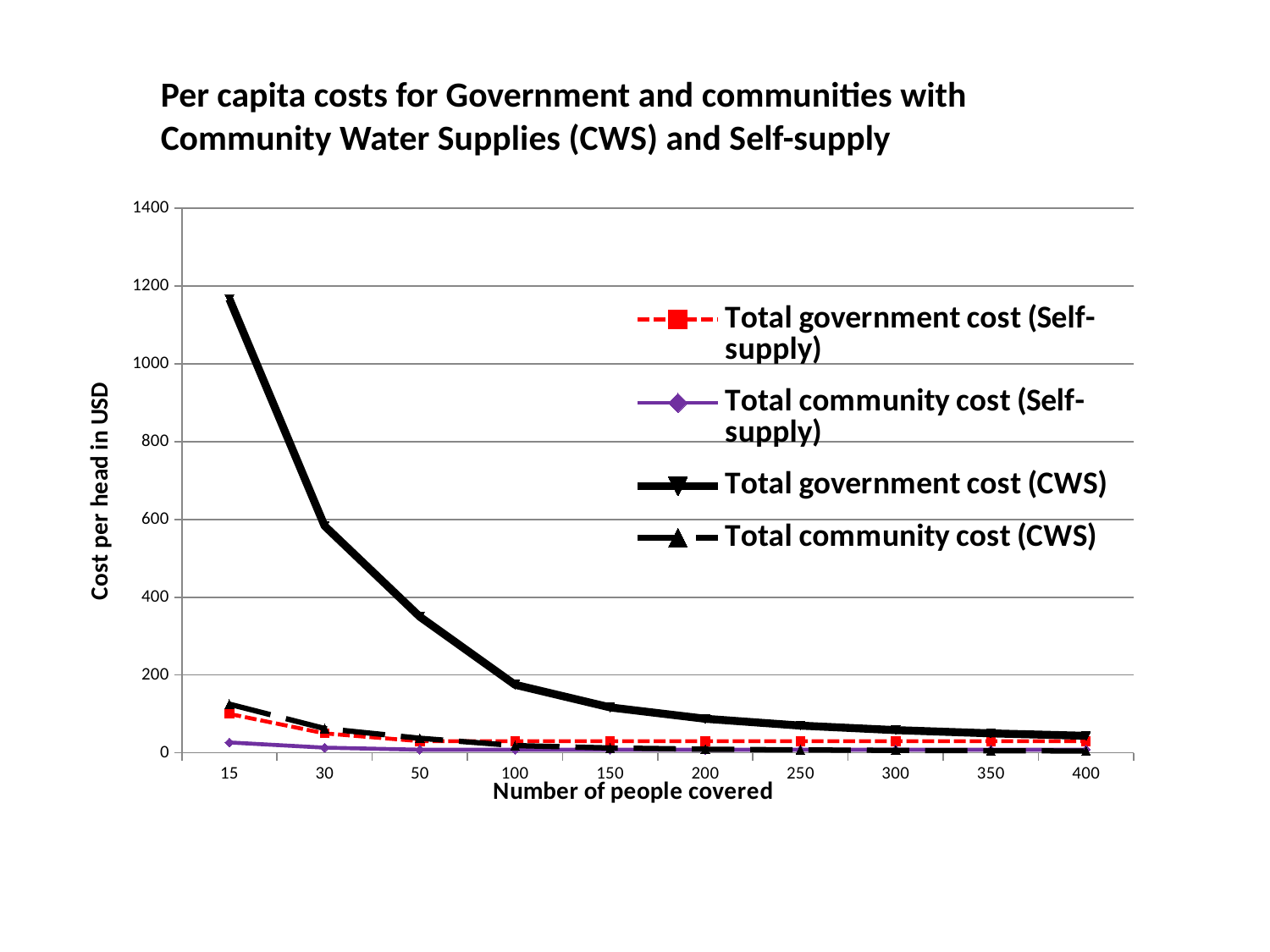
How many series does the legend list? 4 What kind of chart is shown on the slide? line chart Does the Total government cost (CWS) rise or fall as the number of people covered increases? fall Is the Total government cost (CWS) at 100 people covered greater or less than 400? less At 15 people covered, which is larger: Total community cost (CWS) or Total community cost (Self-supply)? Total community cost (CWS) At 15 people covered, which is larger: Total government cost (CWS) or Total government cost (Self-supply)? Total government cost (CWS) Is the Total government cost (CWS) at 30 people covered greater or less than 400? greater Is the Total government cost (CWS) at 15 people covered greater or less than 1000? greater What is the label of the y axis? Cost per head in USD How many values for number of people covered are shown on the x axis? 10 Which series has the highest value at 15 people covered? Total government cost (CWS)